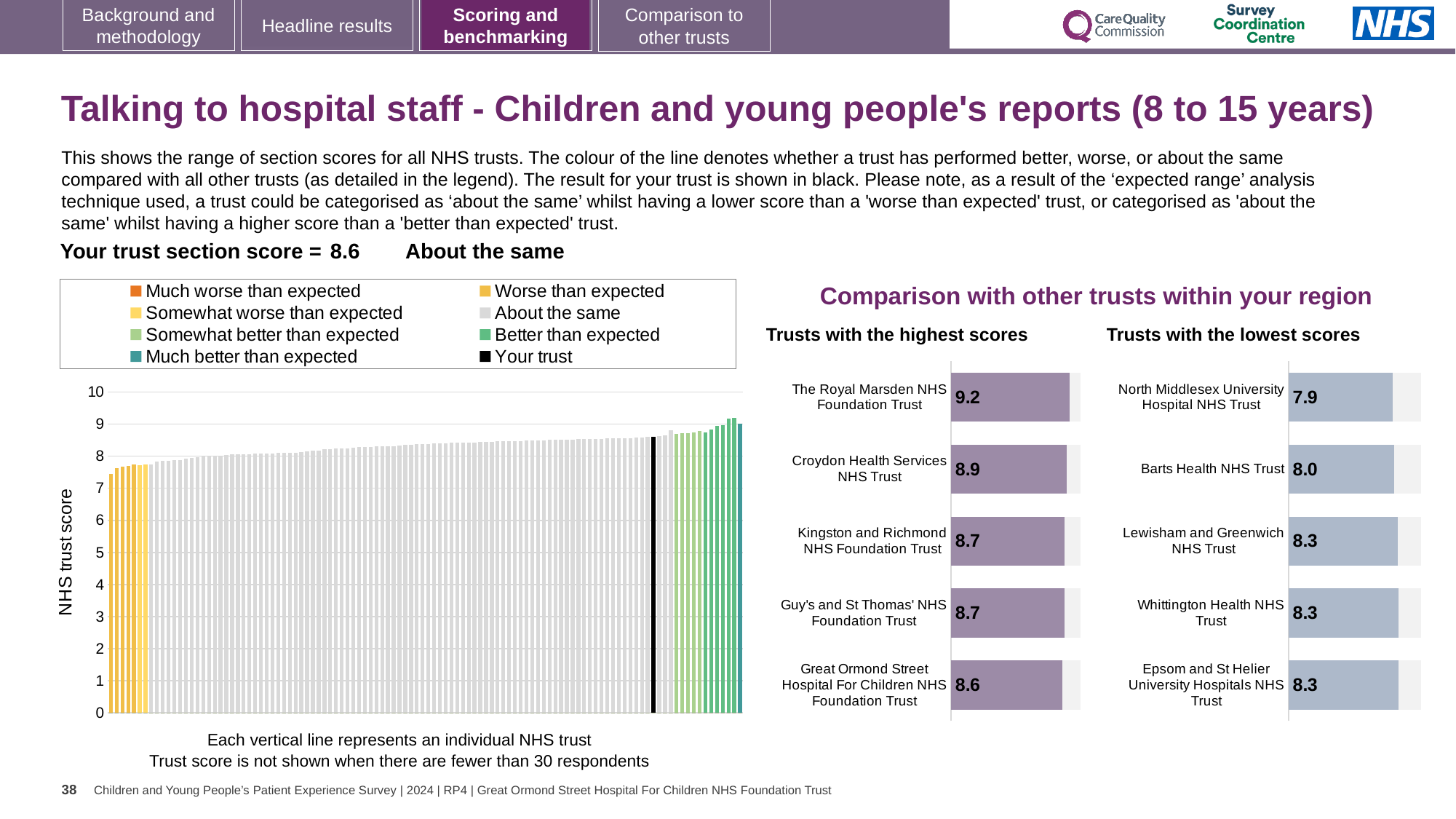
In the 'Trusts with the highest scores' chart, what is the difference between the scores of The Royal Marsden NHS Foundation Trust and Great Ormond Street Hospital For Children NHS Foundation Trust? 0.6 In the 'Trusts with the lowest scores' chart, what is the difference between the scores of Lewisham and Greenwich NHS Trust and North Middlesex University Hospital NHS Trust? 0.4 In the 'Trusts with the lowest scores' chart, what is the score for Barts Health NHS Trust? 8.0 How many entries does the legend above the 'NHS trust score' chart list? 8 In the 'Trusts with the highest scores' chart, how many trusts are shown? 5 In the 'Trusts with the highest scores' chart, which trust has the highest score? The Royal Marsden NHS Foundation Trust What is the label on the vertical axis of the large chart on the left? NHS trust score In the 'Trusts with the highest scores' chart, what is the score for The Royal Marsden NHS Foundation Trust? 9.2 In the 'NHS trust score' chart on the left, is the value for the black 'Your trust' bar greater or less than 8? greater What kind of chart is the large chart on the left with the 'NHS trust score' axis? Bar chart In the 'Trusts with the lowest scores' chart, which has the larger score: Barts Health NHS Trust or North Middlesex University Hospital NHS Trust? Barts Health NHS Trust In the 'Trusts with the lowest scores' chart, which trust has the lowest score? North Middlesex University Hospital NHS Trust